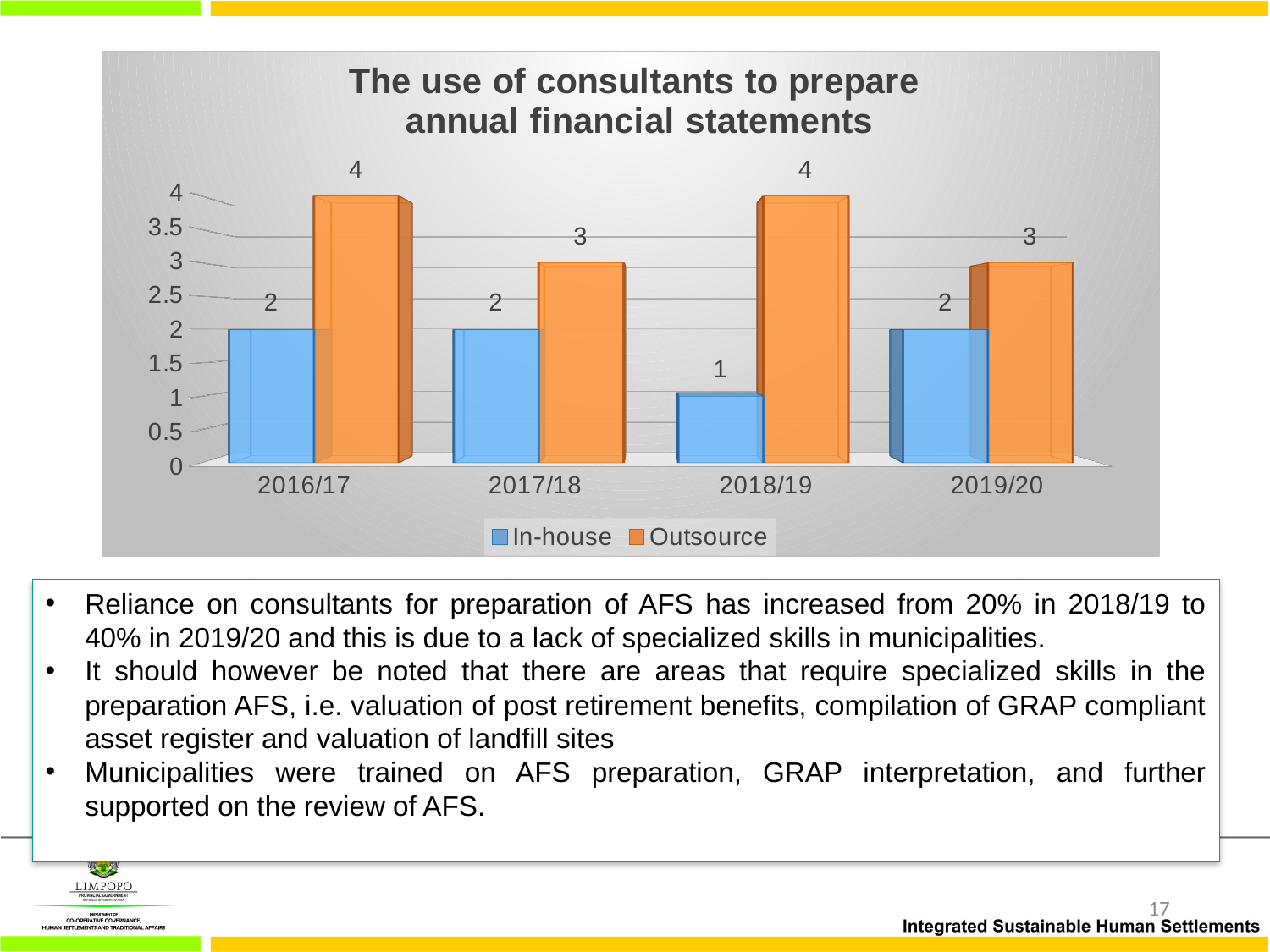
What is the In-house value for 2018/19? 1 Which year has the lowest In-house value? 2018/19 What is the difference between the Outsource and In-house values in 2018/19? 3 What is the total of the In-house and Outsource values for 2016/17? 6 What kind of chart is shown? Bar chart How many series does the legend list? 2 What is the Outsource value for 2017/18? 3 Which colour represents the Outsource series? Orange What is the Outsource value for 2016/17? 4 How many years are shown on the x axis? 4 Which is larger in 2019/20, the In-house value or the Outsource value? Outsource What is the title of the chart? The use of consultants to prepare annual financial statements